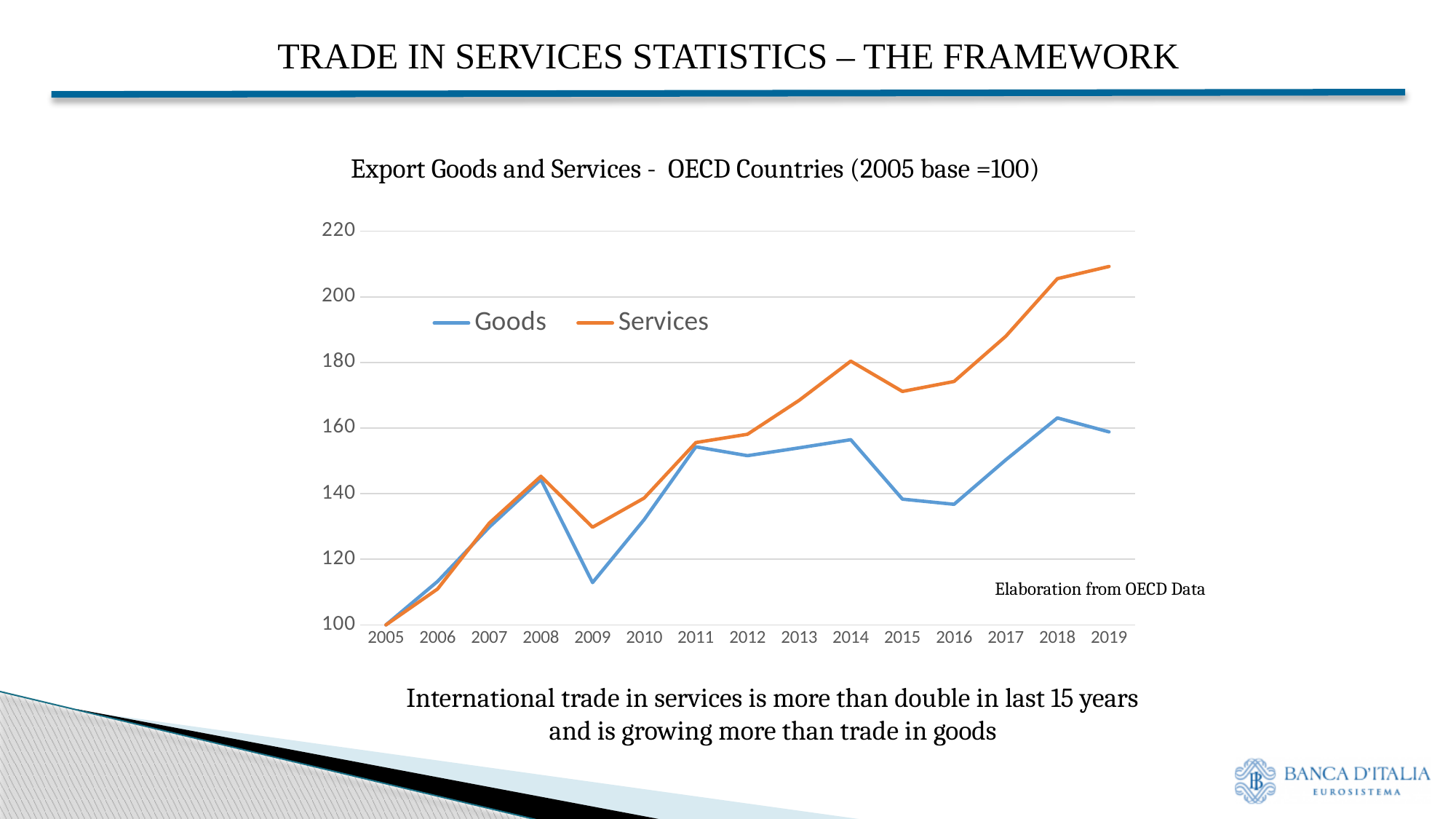
In 2019, which series has the higher value, Goods or Services? Services Which two series are shown in the legend? Goods and Services How many years are plotted along the x axis? 15 How many series does the legend list? 2 What is the value of the Services series in 2005? 100 Is the value for Goods in 2016 greater or less than 140? less Is the value for Goods in 2009 greater or less than 120? less Does the Services series rise or fall between 2016 and 2019? Rise In which year does the Services series reach its highest value? 2019 Is the value for Services in 2019 greater or less than 200? greater What is the value of the Goods series in 2005? 100 What kind of chart is shown on the slide? Line chart